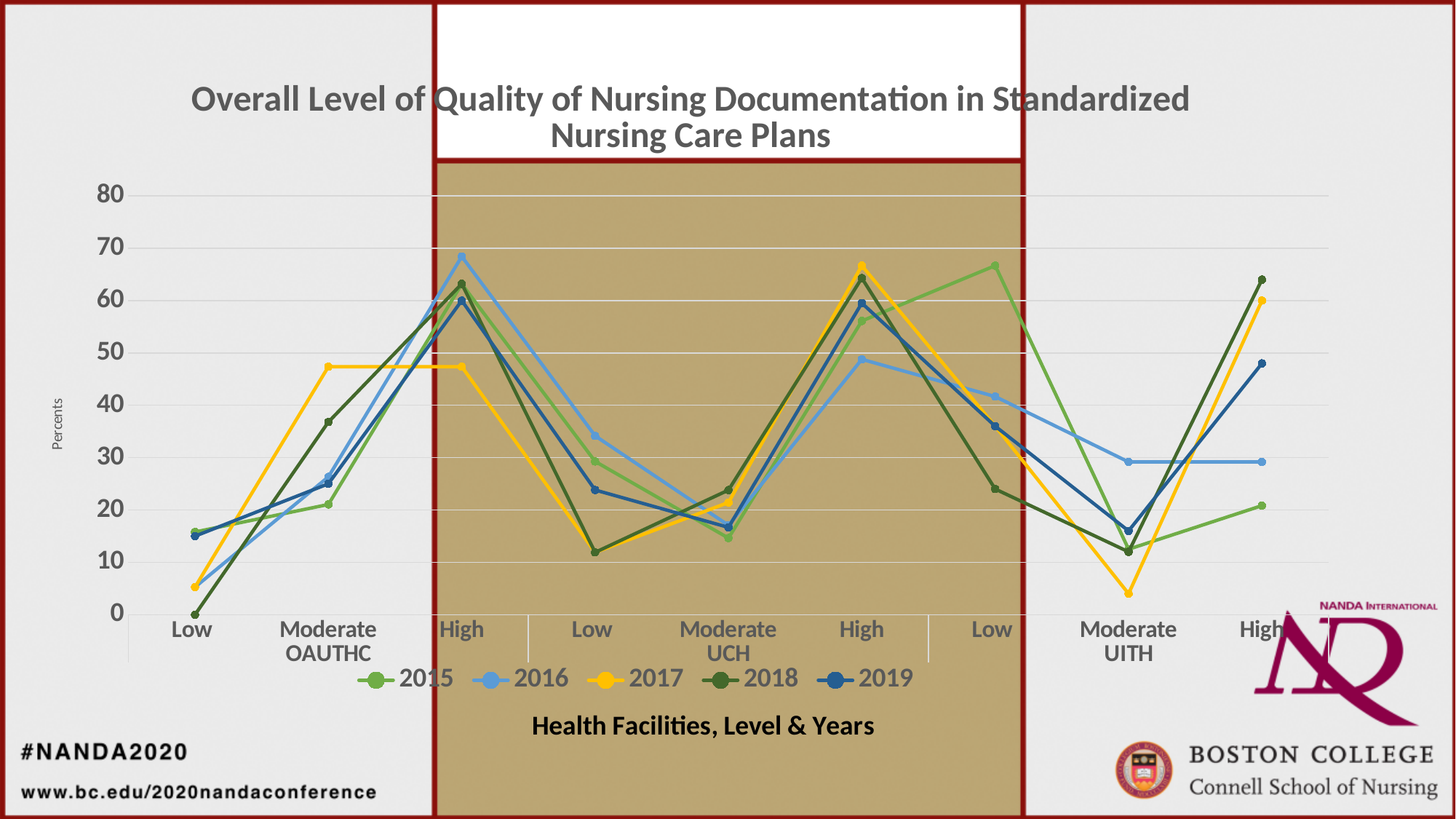
Is the 2018 value for Low at UCH greater or less than 20? less Which series has the highest value for Low at UITH? 2015 How many categories are plotted along the x axis? 9 Is the 2017 value for Moderate at UITH greater or less than 10? less What is the label of the x axis? Health Facilities, Level & Years How many series does the legend list? 5 Is the 2015 value for High at UITH greater or less than 30? less Does the 2016 series rise or fall from Low to High at OAUTHC? rise What kind of chart is shown on the slide? line chart Which series has the lowest value for Low at OAUTHC? 2018 For Moderate at OAUTHC, which is larger: the 2017 value or the 2015 value? 2017